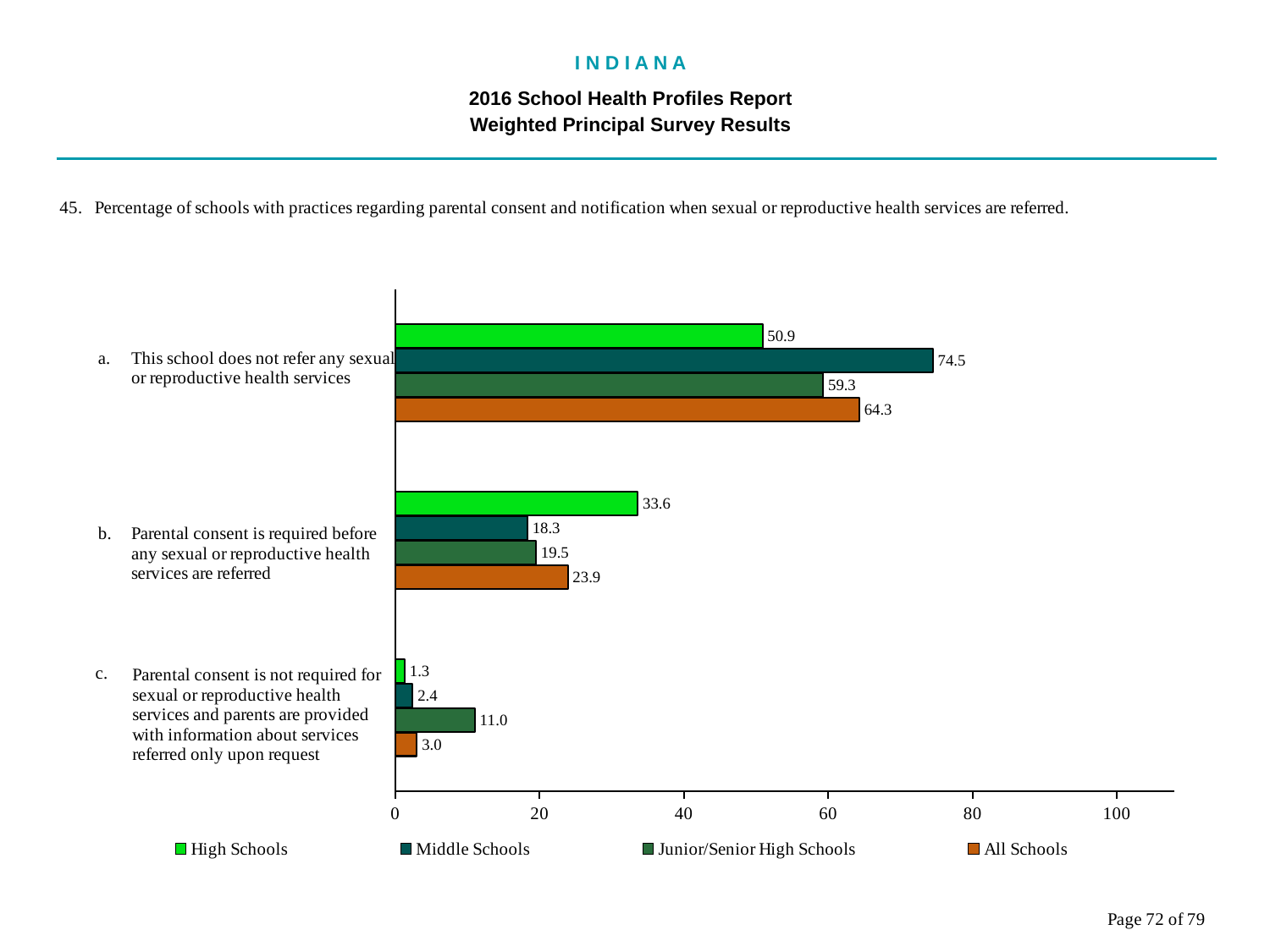
Which series is shown in orange in the legend? All Schools How many series does the legend list? 4 What is the difference between the Middle Schools and High Schools values for 'This school does not refer any sexual or reproductive health services'? 23.6 What is the value for Junior/Senior High Schools for 'Parental consent is not required for sexual or reproductive health services and parents are provided with information about services referred only upon request'? 11.0 What is the value for All Schools for 'Parental consent is required before any sexual or reproductive health services are referred'? 23.9 Which school type has the lowest value for 'Parental consent is not required for sexual or reproductive health services and parents are provided with information about services referred only upon request'? High Schools Which school type has the highest value for 'This school does not refer any sexual or reproductive health services'? Middle Schools How many practice categories are shown on the chart? 3 What kind of chart is shown on the slide? bar chart For 'Parental consent is required before any sexual or reproductive health services are referred', which is larger: the High Schools value or the Middle Schools value? High Schools What is the value for Middle Schools for 'This school does not refer any sexual or reproductive health services'? 74.5 Is the All Schools value for 'This school does not refer any sexual or reproductive health services' greater or less than 60? greater